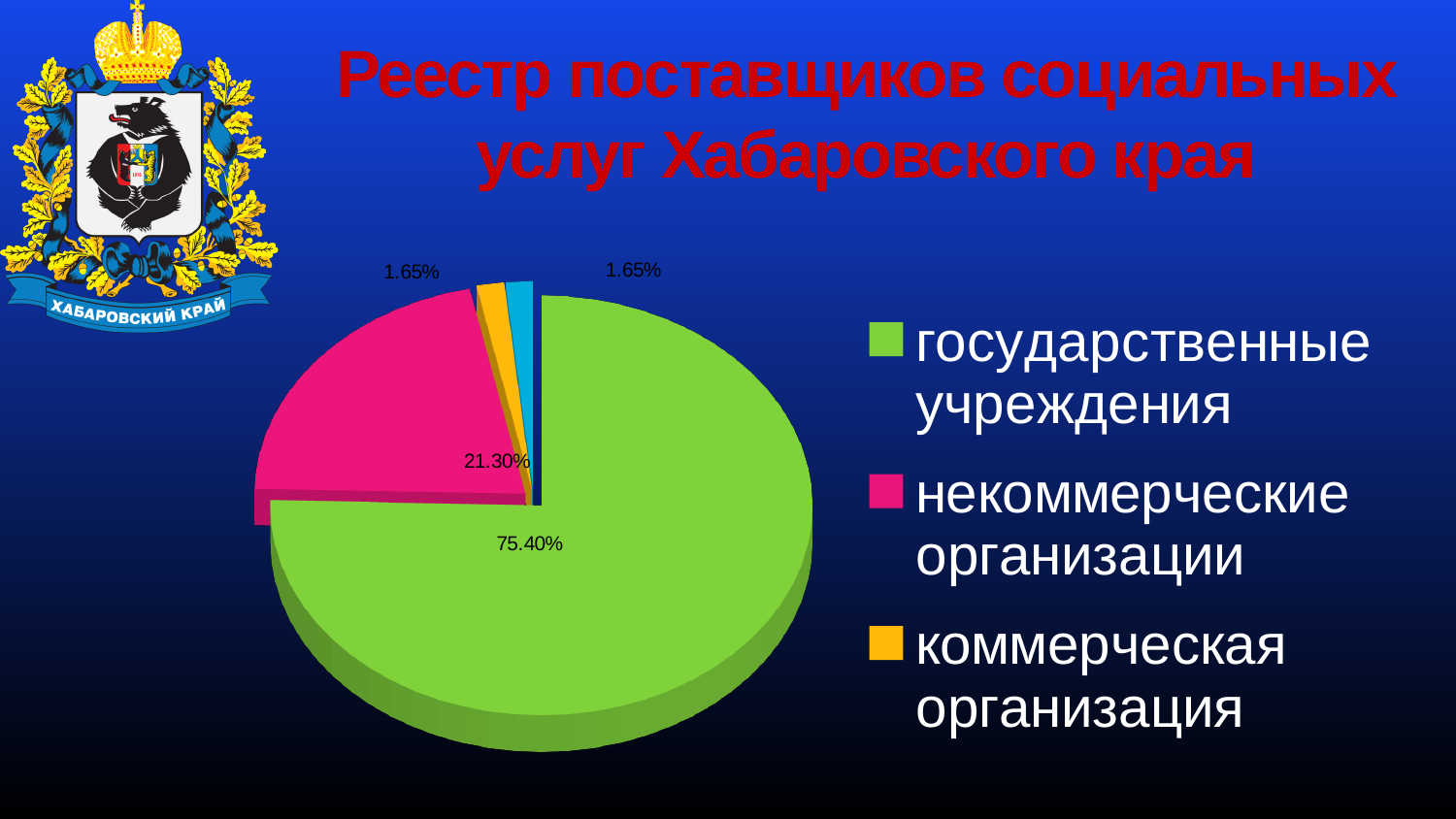
Which category has the largest slice of the pie? государственные учреждения What colour is the slice for некоммерческие организации? pink Which is larger: the share of некоммерческие организации or the share of коммерческая организация? некоммерческие организации What share of the pie is labelled for коммерческая организация? 1.65% What share of the pie is labelled for некоммерческие организации? 21.30% What is the title of the slide containing the chart? Реестр поставщиков социальных услуг Хабаровского края What type of chart is shown on the slide? pie chart How many slices does the pie chart have? 4 What share of the pie is labelled for государственные учреждения? 75.40% What is the smallest percentage value labelled on the pie chart? 1.65% What is the difference between the shares of государственные учреждения and некоммерческие организации? 54.10% How many entries does the legend list? 3